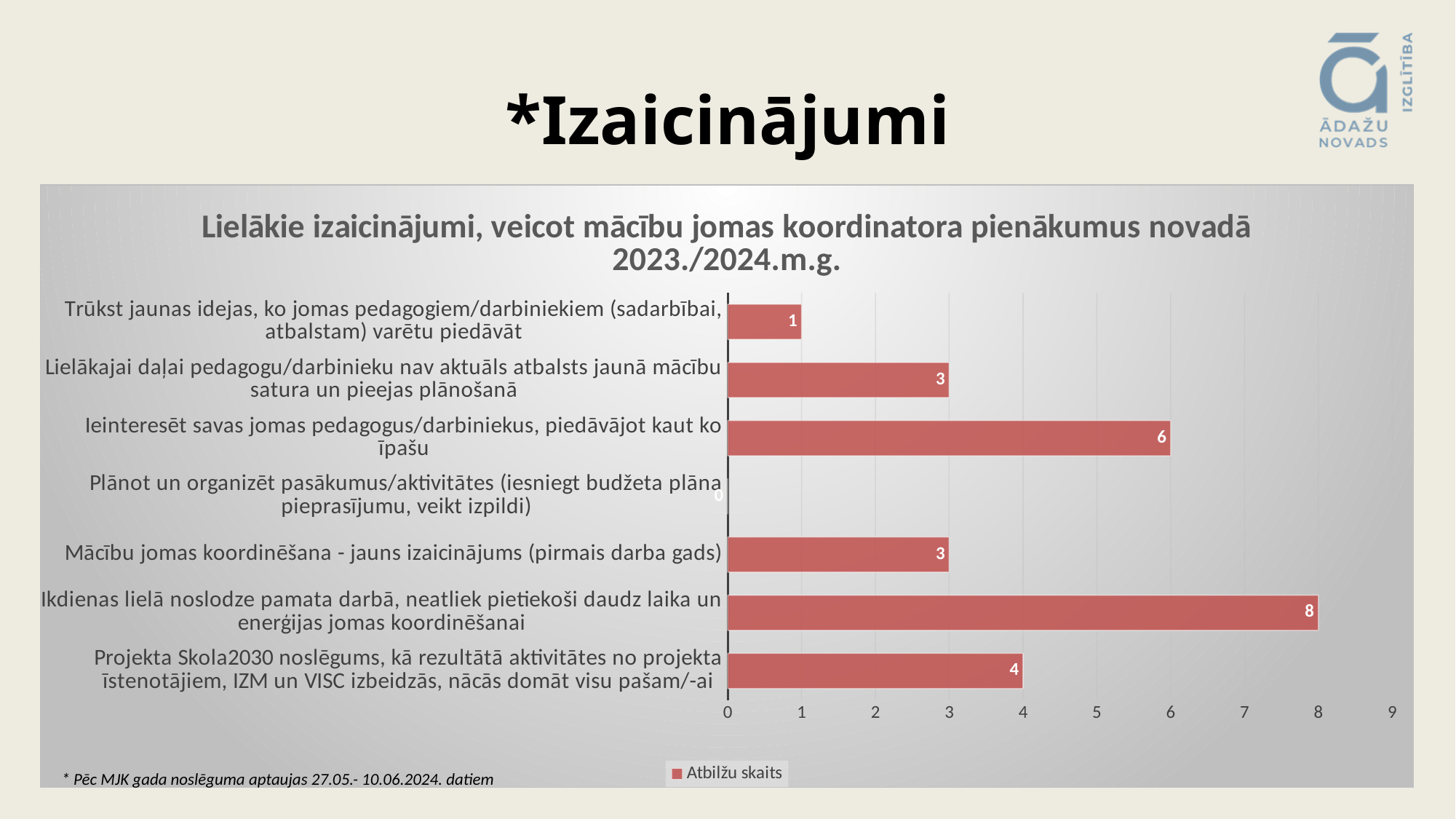
How many categories are shown in the chart? 7 What is the name of the series in the legend? Atbilžu skaits How many series does the legend list? 1 Which category has the highest value? Ikdienas lielā noslodze pamata darbā, neatliek pietiekoši daudz laika un enerģijas jomas koordinēšanai What is the difference between the value for "Ieinteresēt savas jomas pedagogus/darbiniekus, piedāvājot kaut ko īpašu" and the value for "Trūkst jaunas idejas, ko jomas pedagogiem/darbiniekiem (sadarbībai, atbalstam) varētu piedāvāt"? 5 What is the value for "Projekta Skola2030 noslēgums, kā rezultātā aktivitātes no projekta īstenotājiem, IZM un VISC izbeidzās, nācās domāt visu pašam/-ai"? 4 Which is larger: the value for "Projekta Skola2030 noslēgums..." or the value for "Mācību jomas koordinēšana - jauns izaicinājums (pirmais darba gads)"? Projekta Skola2030 noslēgums... What kind of chart is shown on the slide? Bar chart What is the value for "Ikdienas lielā noslodze pamata darbā, neatliek pietiekoši daudz laika un enerģijas jomas koordinēšanai"? 8 What is the title of the chart? Lielākie izaicinājumi, veicot mācību jomas koordinatora pienākumus novadā 2023./2024.m.g. Which category has the lowest value? Plānot un organizēt pasākumus/aktivitātes (iesniegt budžeta plāna pieprasījumu, veikt izpildi) What is the value for "Plānot un organizēt pasākumus/aktivitātes (iesniegt budžeta plāna pieprasījumu, veikt izpildi)"? 0